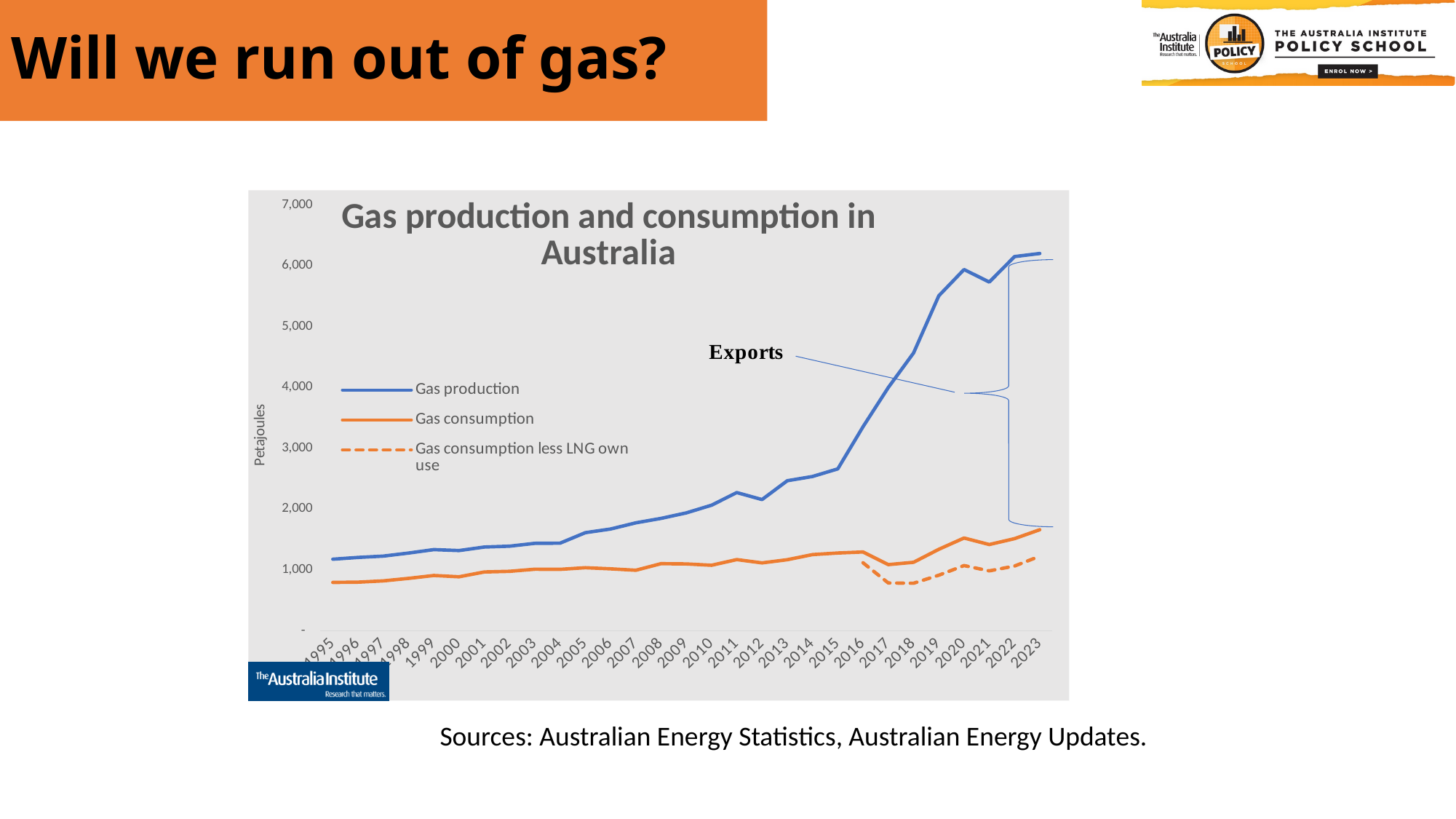
In which year is Gas production lowest? 1995 Is the value for Gas production in 2015 greater or less than 3,000? less Does gas production generally rise or fall from 1995 to 2023? rise How many series does the legend of the chart list? 3 How many years are shown on the x axis of the chart? 29 Is the value for Gas consumption in 2023 greater or less than 2,000? less Is the value for Gas production in 2023 greater or less than 6,000? greater In 2023, which is larger: Gas production or Gas consumption? Gas production What kind of chart is shown on the slide? line chart What unit is shown on the y axis of the chart? Petajoules What is the title of the chart? Gas production and consumption in Australia